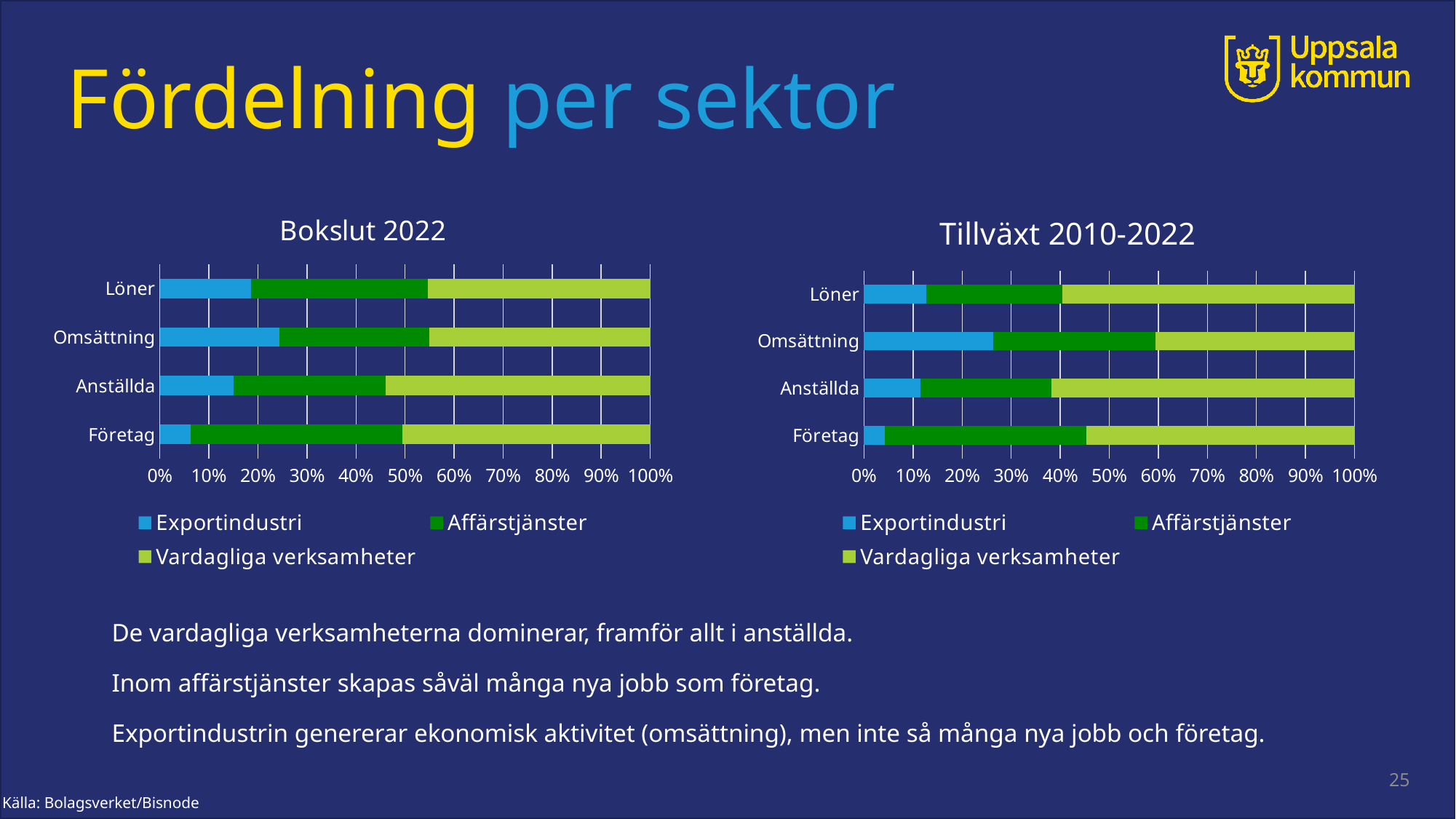
In the "Tillväxt 2010-2022" chart, which is larger for Anställda: the Affärstjänster share or the Vardagliga verksamheter share? Vardagliga verksamheter What kind of chart is the "Bokslut 2022" chart? Stacked bar chart In the "Tillväxt 2010-2022" chart, is the Exportindustri share for Omsättning greater or less than 20%? greater How many series does the legend of the "Bokslut 2022" chart list? 3 How many categories are shown on the y axis of the "Tillväxt 2010-2022" chart? 4 In the "Tillväxt 2010-2022" chart, which category has the smallest Exportindustri share? Företag What is the title of the chart on the right side of the slide? Tillväxt 2010-2022 In the "Bokslut 2022" chart, which is larger for Företag: the Exportindustri share or the Affärstjänster share? Affärstjänster In the "Bokslut 2022" chart, which category has the smallest Exportindustri share? Företag In the "Tillväxt 2010-2022" chart, which category has the largest Exportindustri share? Omsättning In the "Bokslut 2022" chart, is the Exportindustri share for Företag greater or less than 10%? less In the "Bokslut 2022" chart, which category has the largest Exportindustri share? Omsättning